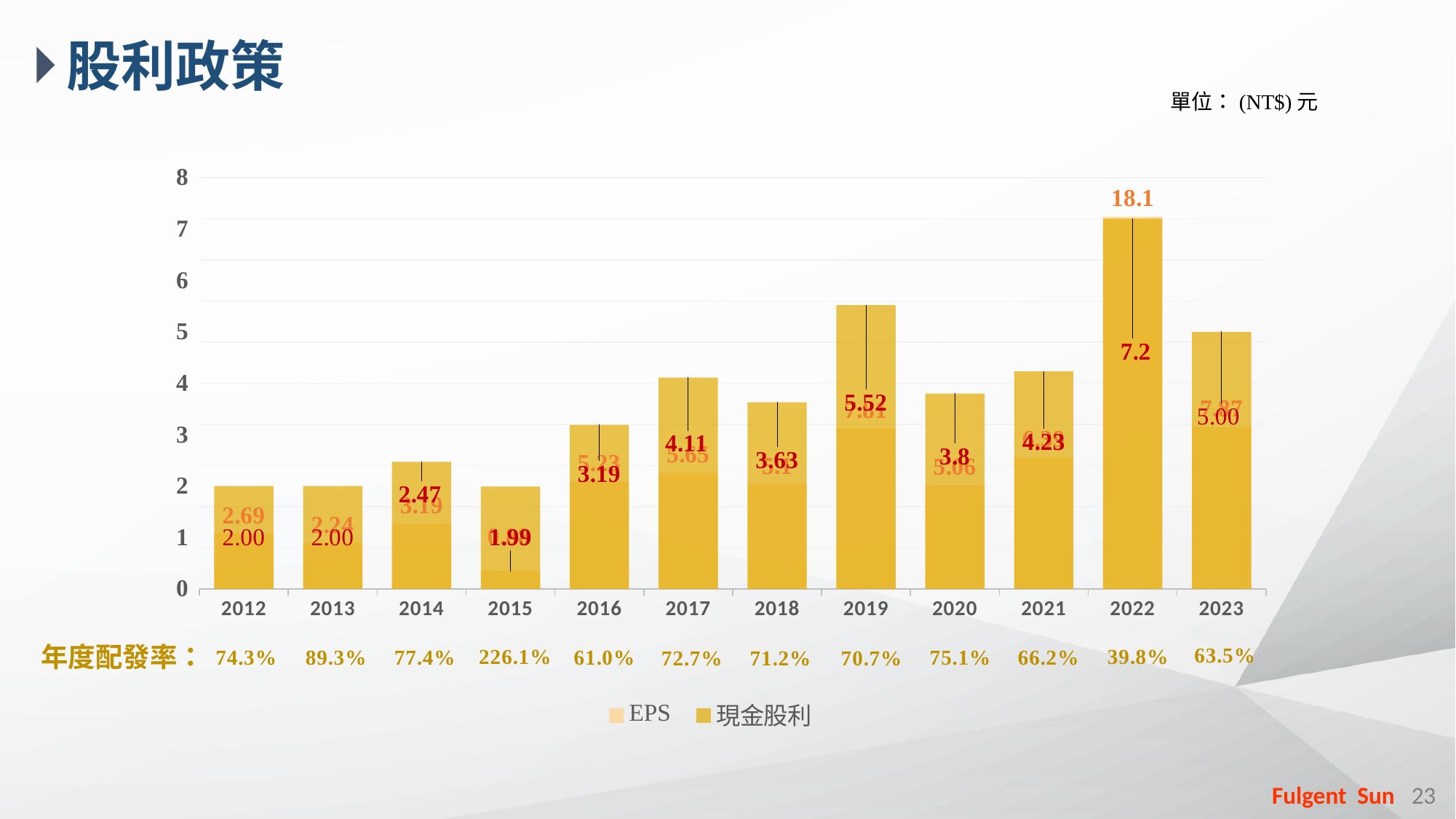
Which year has the larger 現金股利 value, 2017 or 2018? 2017 What kind of chart is shown on the slide? bar chart What is the EPS value labelled for 2022? 18.1 What is the difference between the 現金股利 values for 2022 and 2023? 2.2 What is the 現金股利 (cash dividend) value for 2022? 7.2 How many years are shown on the x axis of the chart? 12 How many series does the legend list? 2 What is the 現金股利 value for 2012? 2.00 Which year has the highest 現金股利 value? 2022 Which year has the lowest 現金股利 value? 2015 What is the 年度配發率 (annual payout rate) shown for 2015? 226.1% What is the 現金股利 value for 2019? 5.52